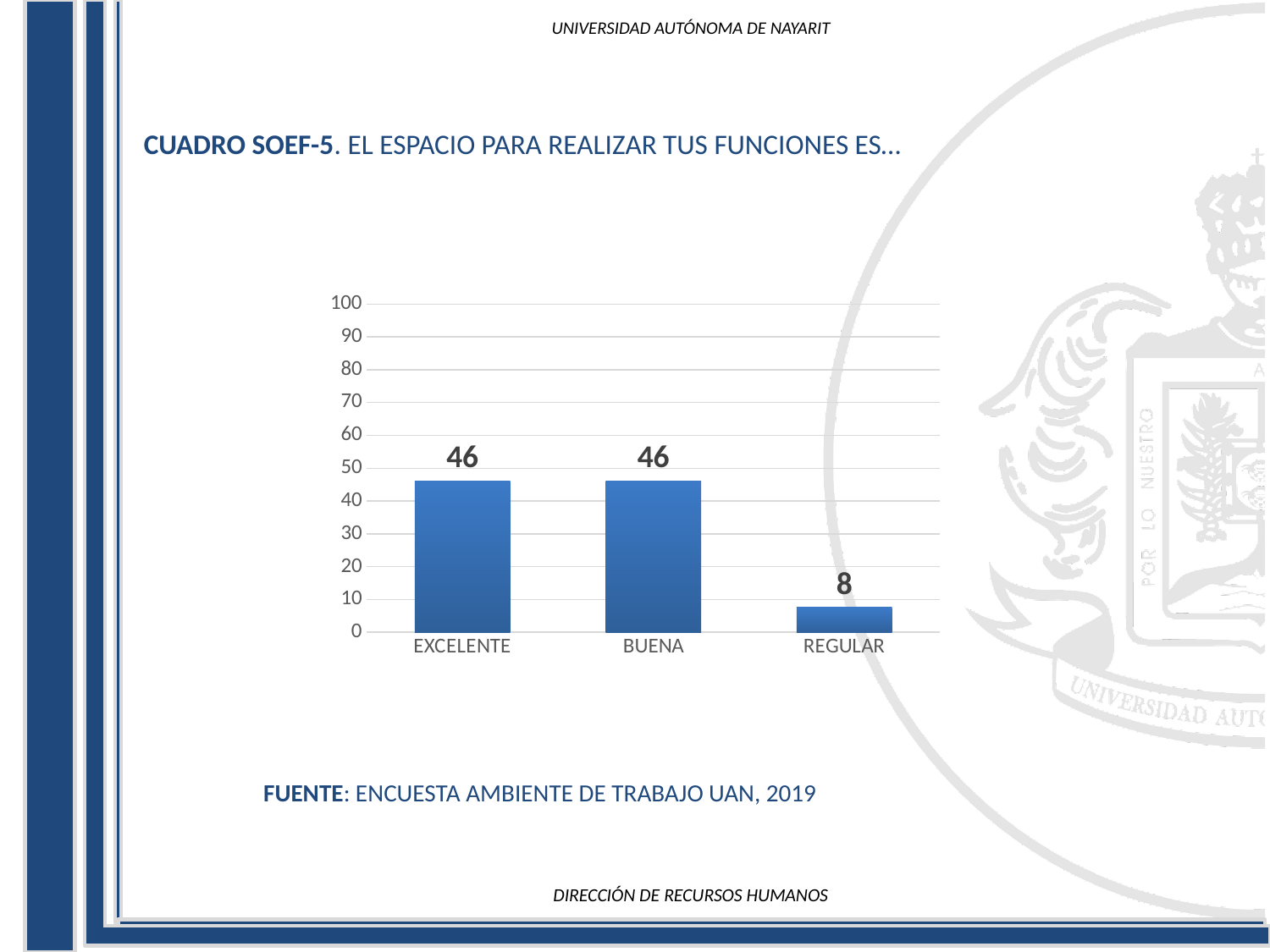
What is the maximum value shown on the vertical axis? 100 Which is larger, the value for EXCELENTE or the value for REGULAR? EXCELENTE Is the value for REGULAR greater or less than 10? less What is the value for BUENA? 46 What is the difference between the values for BUENA and REGULAR? 38 What is the difference between the values for EXCELENTE and BUENA? 0 What kind of chart is shown on the slide? bar chart Which category has the lowest value? REGULAR Is the value for BUENA greater or less than 40? greater What is the value for REGULAR? 8 What is the value for EXCELENTE? 46 How many categories are shown on the x axis? 3